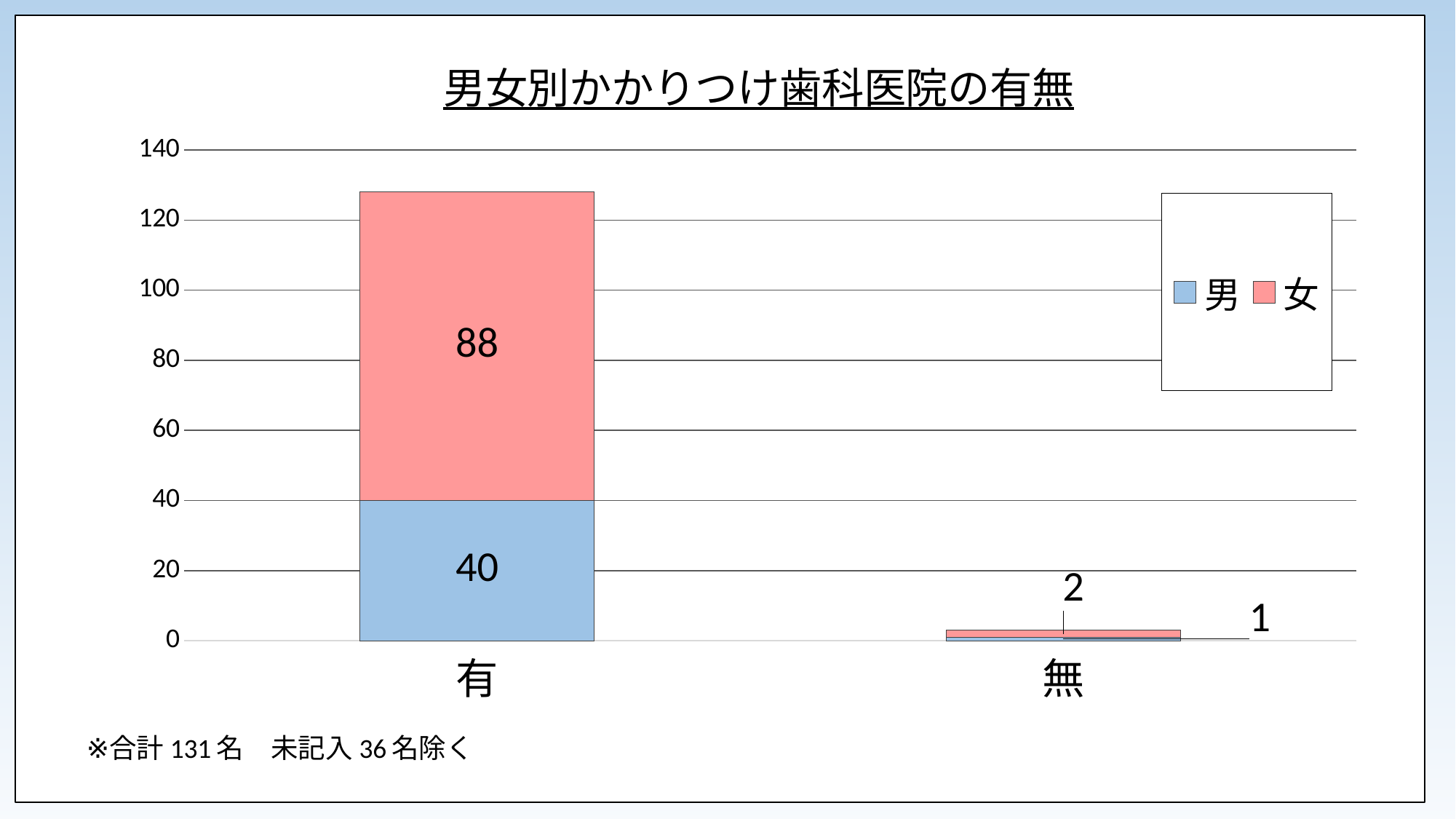
What is the total of the stacked bar for 有? 128 How many series does the legend list? 2 What is the value for 女 in the 無 category? 2 What is the difference between the 女 and 男 values in the 有 category? 48 What is the value for 男 in the 有 category? 40 What is the value for 女 in the 有 category? 88 What type of chart is shown on the slide? Stacked bar chart Which category has the higher total, 有 or 無? 有 How many categories are shown on the x axis? 2 Which colour represents the 男 series in the legend? Blue What is the value for 男 in the 無 category? 1 What is the title of the chart? 男女別かかりつけ歯科医院の有無